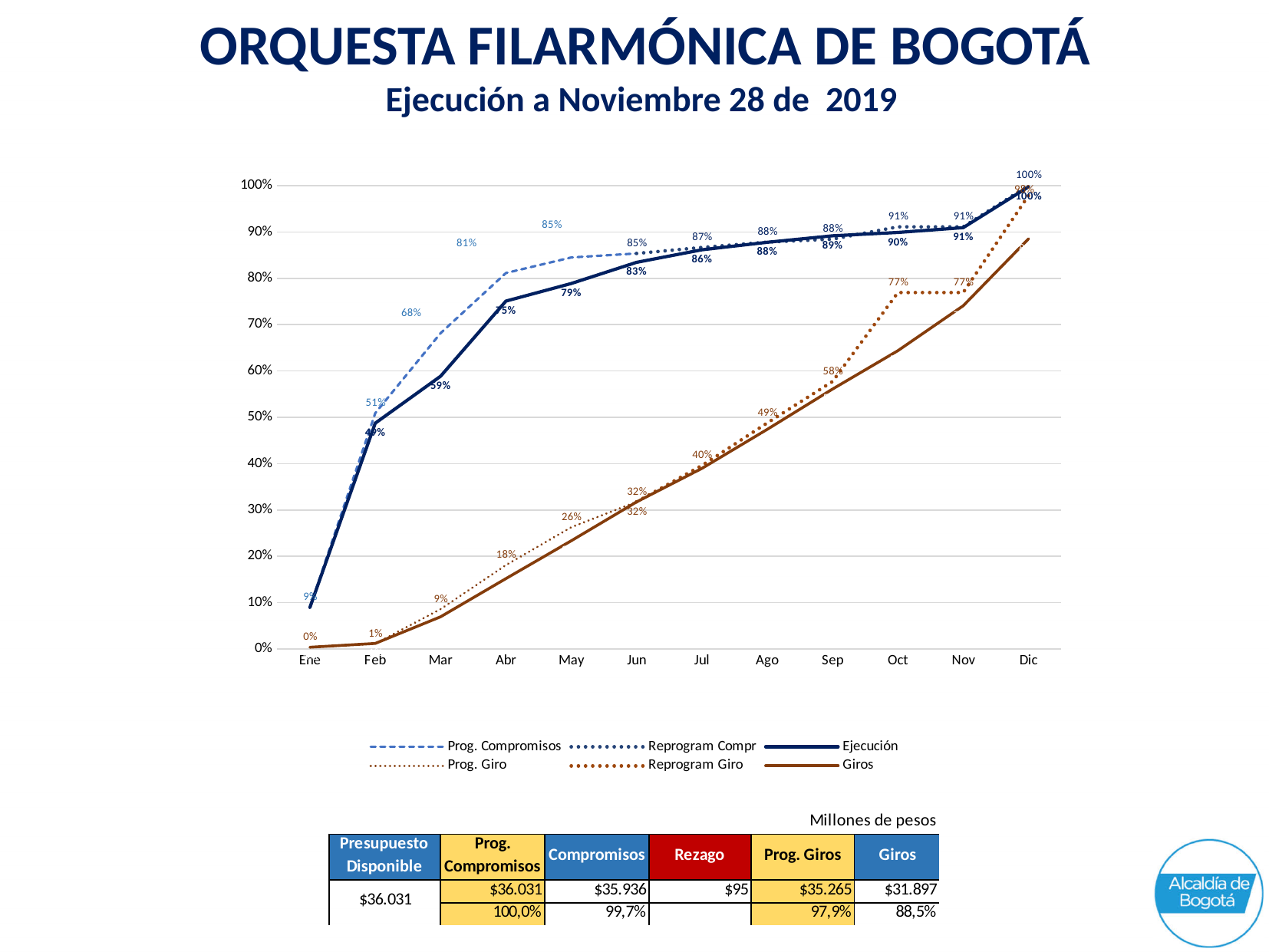
What is the Ejecución value for Jun? 83% What is the Ejecución value for Nov? 91% In Jun, which series has the larger value, Ejecución or Giros? Ejecución How many months are shown along the x axis of the chart? 12 What is the Prog. Compromisos value for Mar? 68% Do the Giros values rise or fall from Ene to Dic? rise What is the Prog. Compromisos value for Abr? 81% In which month does the Ejecución series reach its highest value? Dic Is the Giros value for Dic greater or less than 80%? greater What is the difference between the Ejecución values for Nov and Jun? 8 percentage points What kind of chart is shown on the slide? line chart How many series does the chart legend list? 6